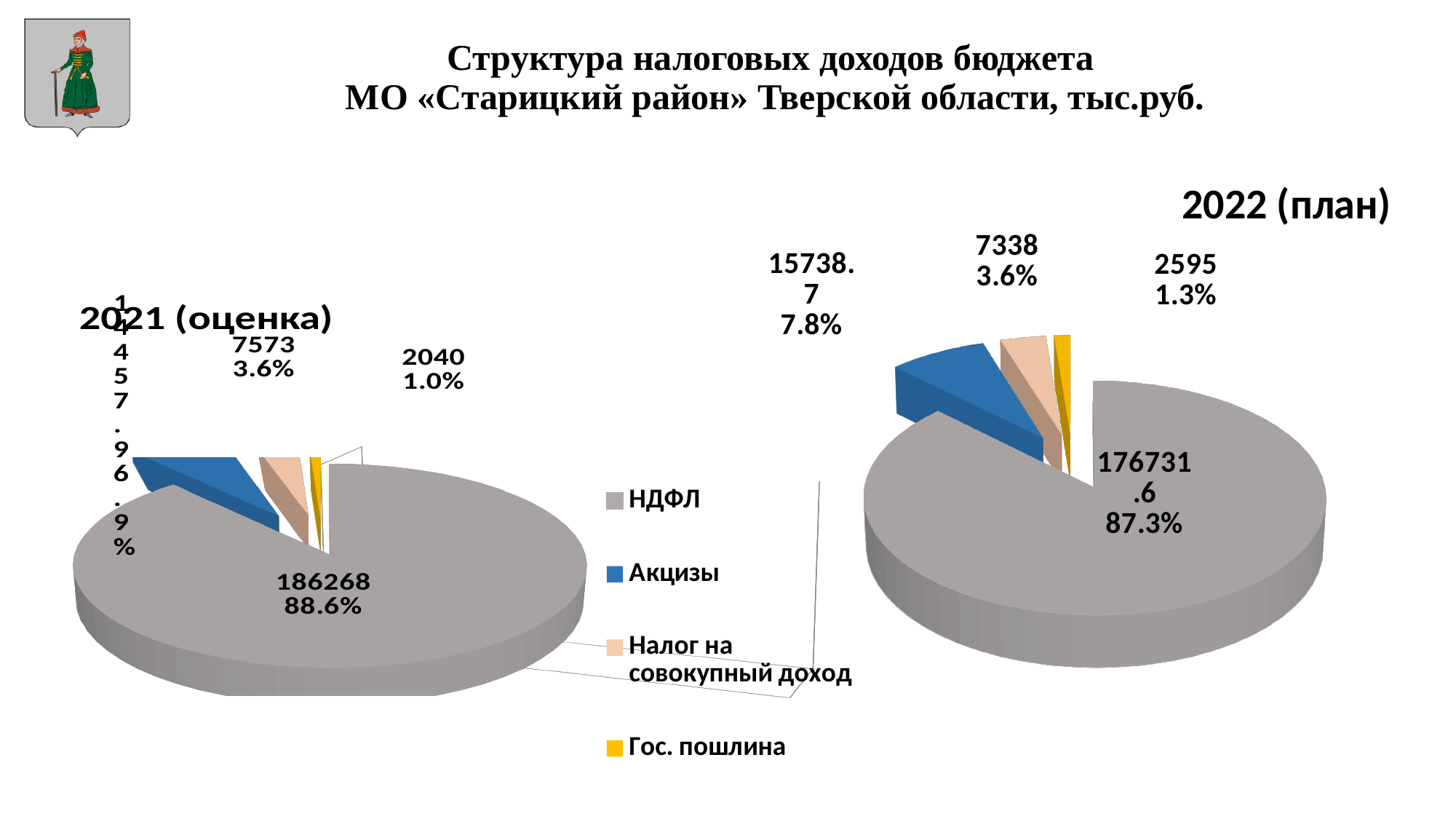
In the 2021 (оценка) chart, which category has the largest slice? НДФЛ Which colour represents Акцизы in the legend? blue In the 2022 (план) chart, what share of the pie does Акцизы have? 7.8% In the 2022 (план) chart, which category has the smallest slice? Гос. пошлина Which is larger: the value for Гос. пошлина in the 2021 (оценка) chart or in the 2022 (план) chart? 2022 (план) In the 2022 (план) chart, what value is shown for НДФЛ? 176731.6 In the 2021 (оценка) chart, what share of the pie does Гос. пошлина have? 1.0% In the 2021 (оценка) chart, what value is shown for Налог на совокупный доход? 7573 What kind of chart is the 2022 (план) chart? pie chart How many series does the legend list? 4 In the 2022 (план) chart, what share of the pie does НДФЛ have? 87.3% In the 2022 (план) chart, what is the difference between the values for Акцизы and Налог на совокупный доход? 8400.7